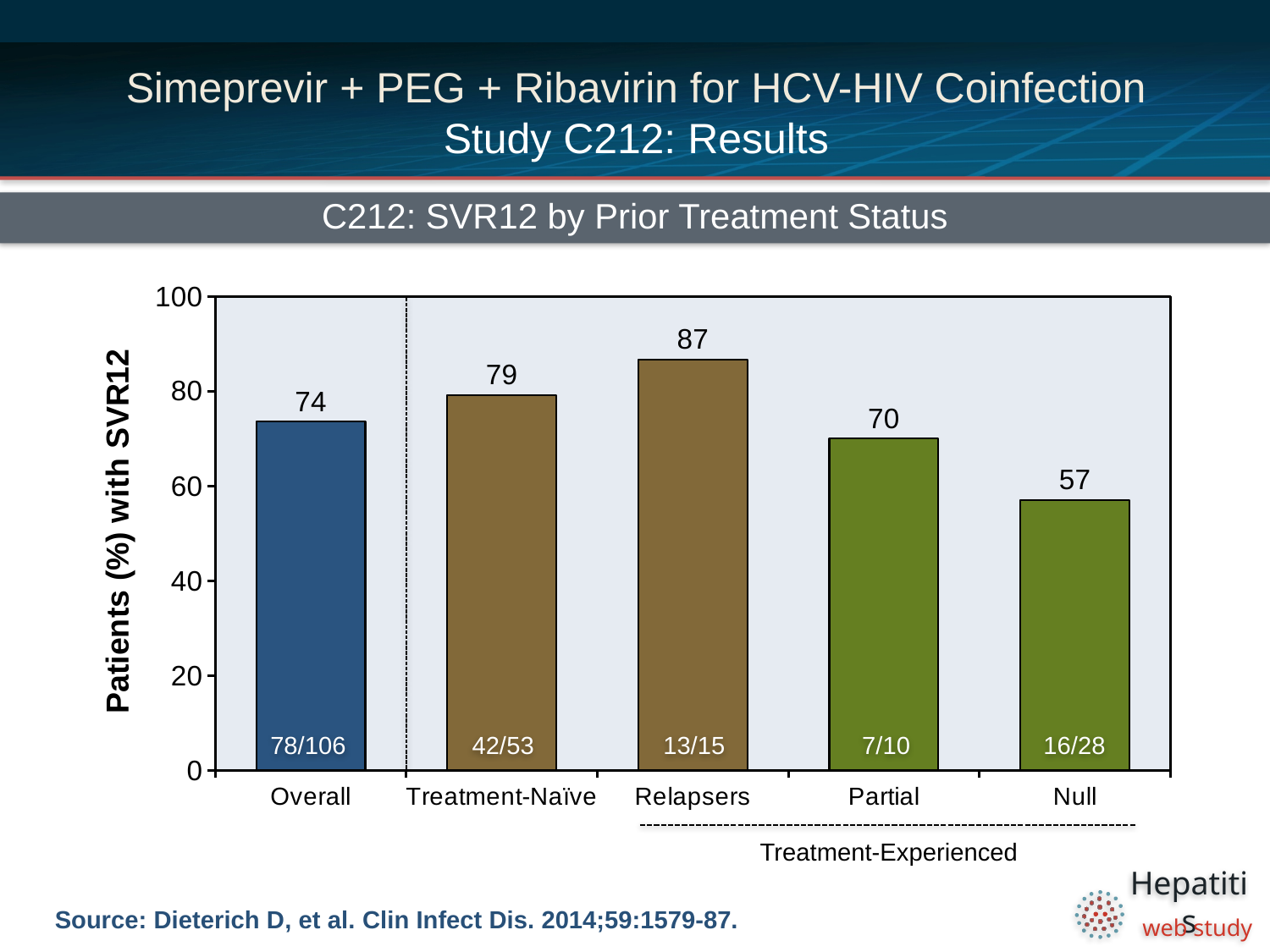
What is the SVR12 rate (%) for Relapsers? 87 What kind of chart is shown on the slide? Bar chart What is the SVR12 rate (%) for the Overall group? 74 Which category has the highest SVR12 rate? Relapsers Which category has the lowest SVR12 rate? Null What is the difference in SVR12 rate between Treatment-Naïve and Partial? 9 Which has a higher SVR12 rate, Treatment-Naïve or Partial? Treatment-Naïve What is the title of the chart? C212: SVR12 by Prior Treatment Status What fraction of patients is shown inside the Treatment-Naïve bar? 42/53 What is the SVR12 rate (%) for the Null group? 57 How many categories are shown on the x axis? 5 What is the difference in SVR12 rate between Relapsers and Null? 30